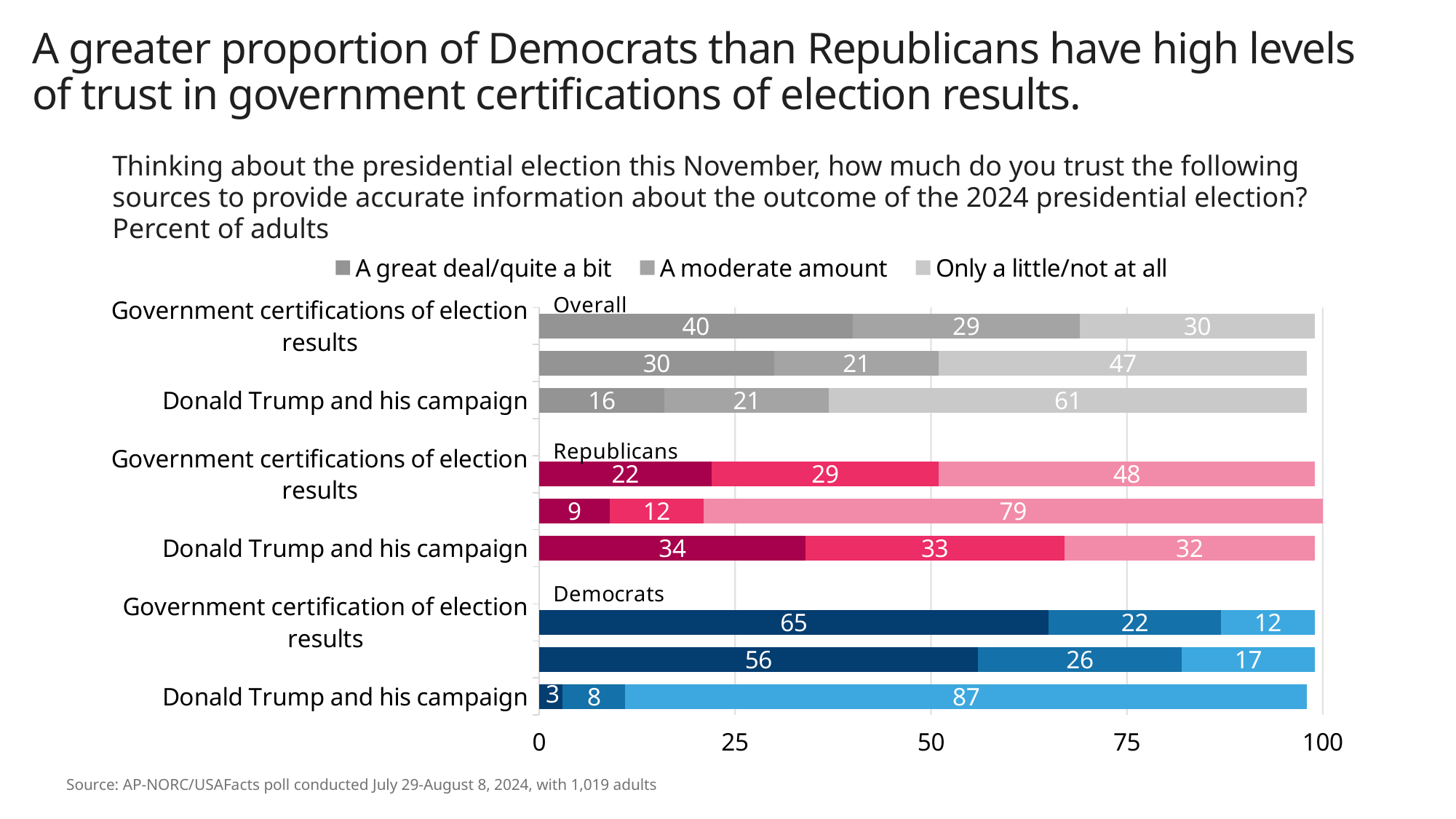
In the Overall group, what percentage of adults trust government certifications of election results 'A great deal/quite a bit'? 40 How many series does the legend list? 3 In the Republicans group, what percentage trust Donald Trump and his campaign 'Only a little/not at all'? 32 Among Overall, Republicans and Democrats, which group has the highest 'Only a little/not at all' share for Donald Trump and his campaign? Democrats What are the three legend entries on the chart? A great deal/quite a bit; A moderate amount; Only a little/not at all What kind of chart is shown on the slide? Stacked bar chart In the Democrats group, what percentage trust Donald Trump and his campaign 'Only a little/not at all'? 87 In the Democrats group, what percentage trust government certification of election results 'A great deal/quite a bit'? 65 What is the total of the three labelled segments for government certifications of election results in the Overall group? 99 In the Overall group, what percentage trust Donald Trump and his campaign 'Only a little/not at all'? 61 Which group has the larger 'A great deal/quite a bit' share for Donald Trump and his campaign, Republicans or Democrats? Republicans How many percentage points higher is the 'A great deal/quite a bit' share for government certifications among Democrats (65) than among Republicans (22)? 43